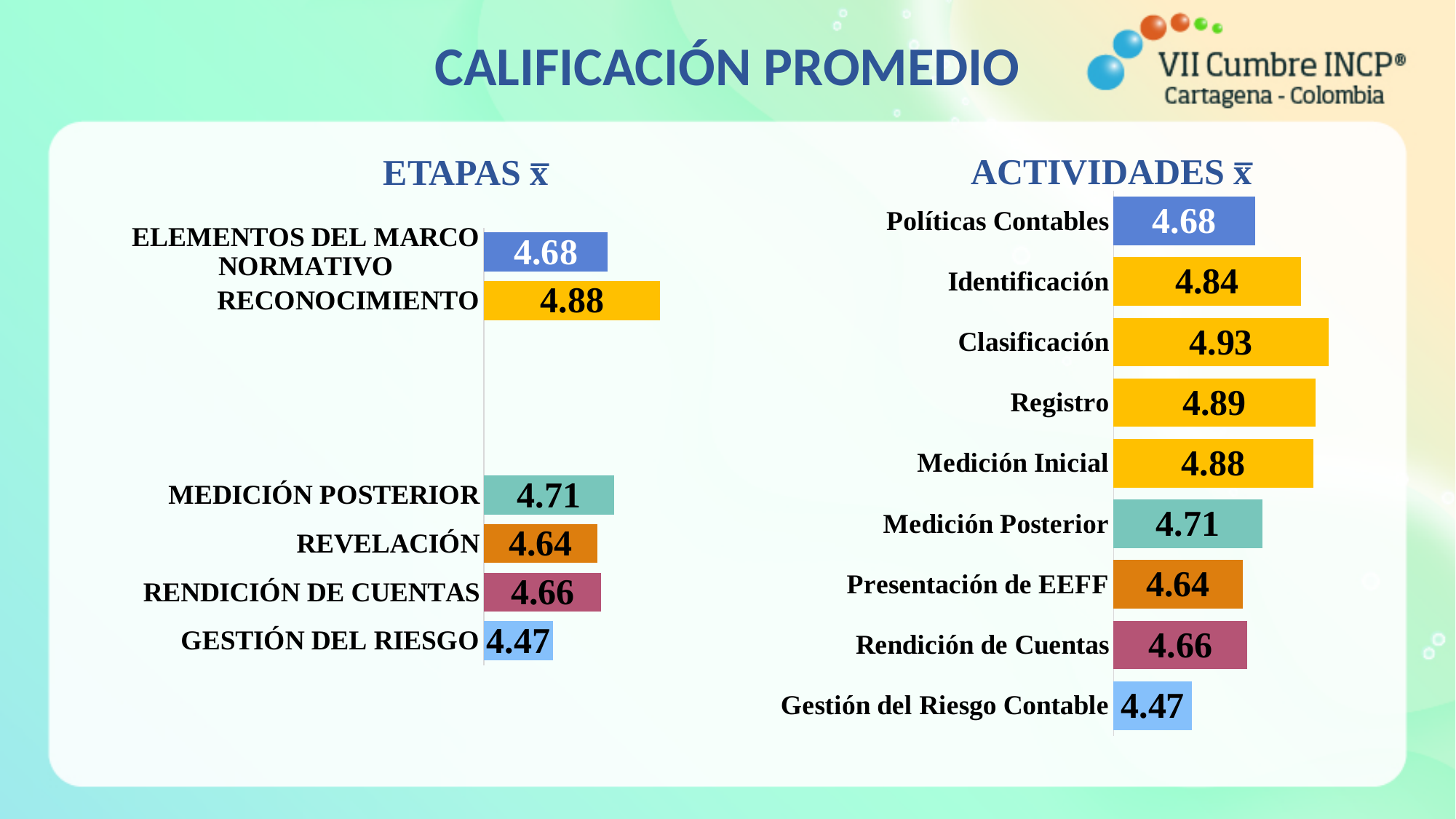
In the ETAPAS chart, what is the value for GESTIÓN DEL RIESGO? 4.47 In the ACTIVIDADES chart, which category has the highest value? Clasificación In the ACTIVIDADES chart, what is the value for Presentación de EEFF? 4.64 In the ACTIVIDADES chart, how many categories are shown? 9 In the ETAPAS chart, which category has the lowest value? GESTIÓN DEL RIESGO In the ETAPAS chart, which category has the highest value? RECONOCIMIENTO What type of chart is the ACTIVIDADES chart? Bar chart In the ACTIVIDADES chart, what is the value for Clasificación? 4.93 In the ETAPAS chart, what is the value for RECONOCIMIENTO? 4.88 In the ACTIVIDADES chart, which is larger, Identificación or Registro? Registro In the ETAPAS chart, what is the difference between RECONOCIMIENTO and GESTIÓN DEL RIESGO? 0.41 In the ETAPAS chart, how many categories are shown? 6